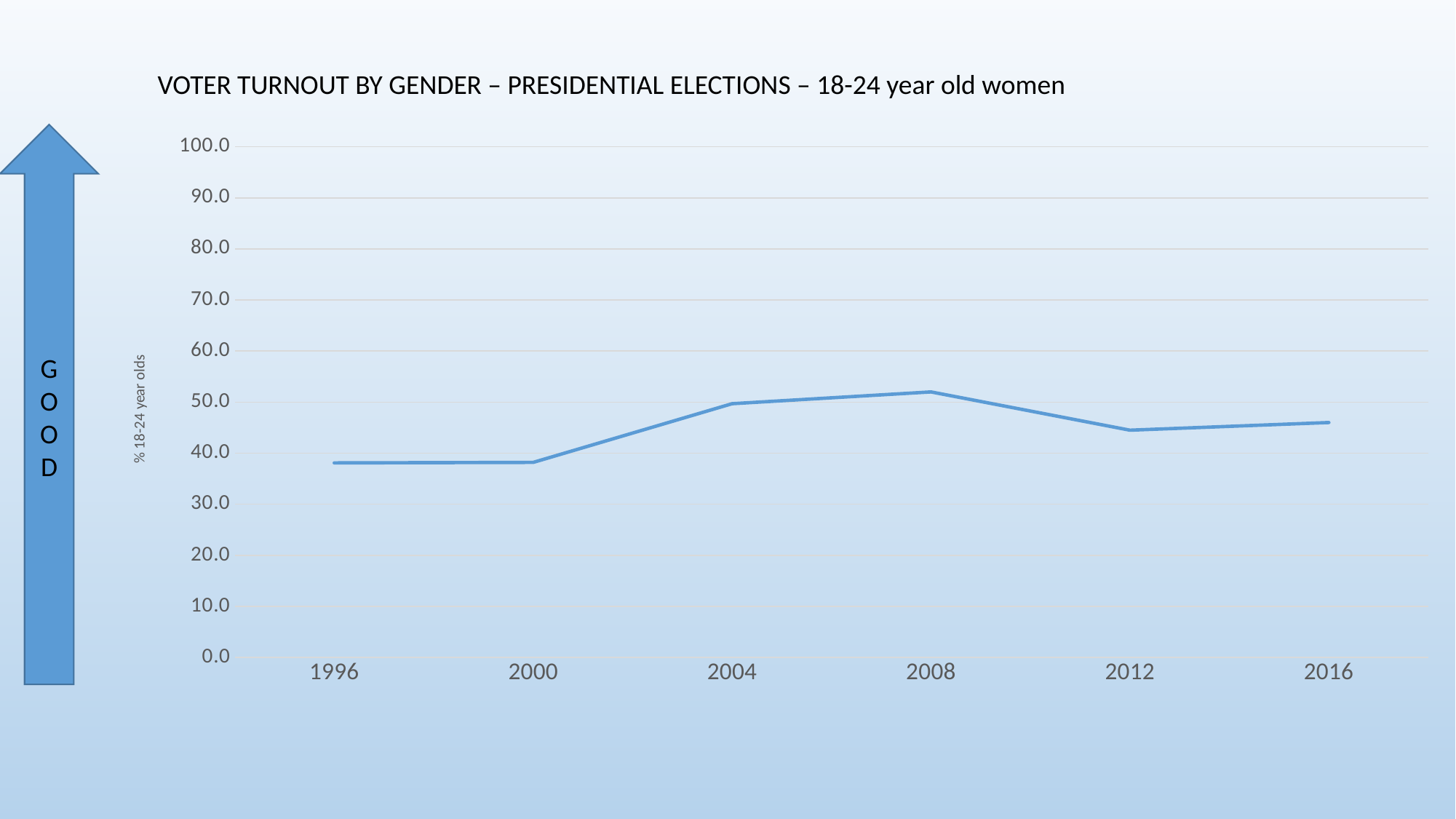
How many election years are plotted on the x axis? 6 Which year has the larger value, 2008 or 2016? 2008 What kind of chart is shown on the slide? line chart Is the value for 2016 greater or less than 40.0? greater What is the label on the vertical axis of the chart? % 18-24 year olds Does the line rise or fall between 2008 and 2012? fall Is the value for 2012 greater or less than 50.0? less Is the value for 2008 greater or less than 50.0? greater Does the line rise or fall between 2000 and 2004? rise Which year has the highest voter turnout value on the chart? 2008 Which year has the larger value, 2004 or 2012? 2004